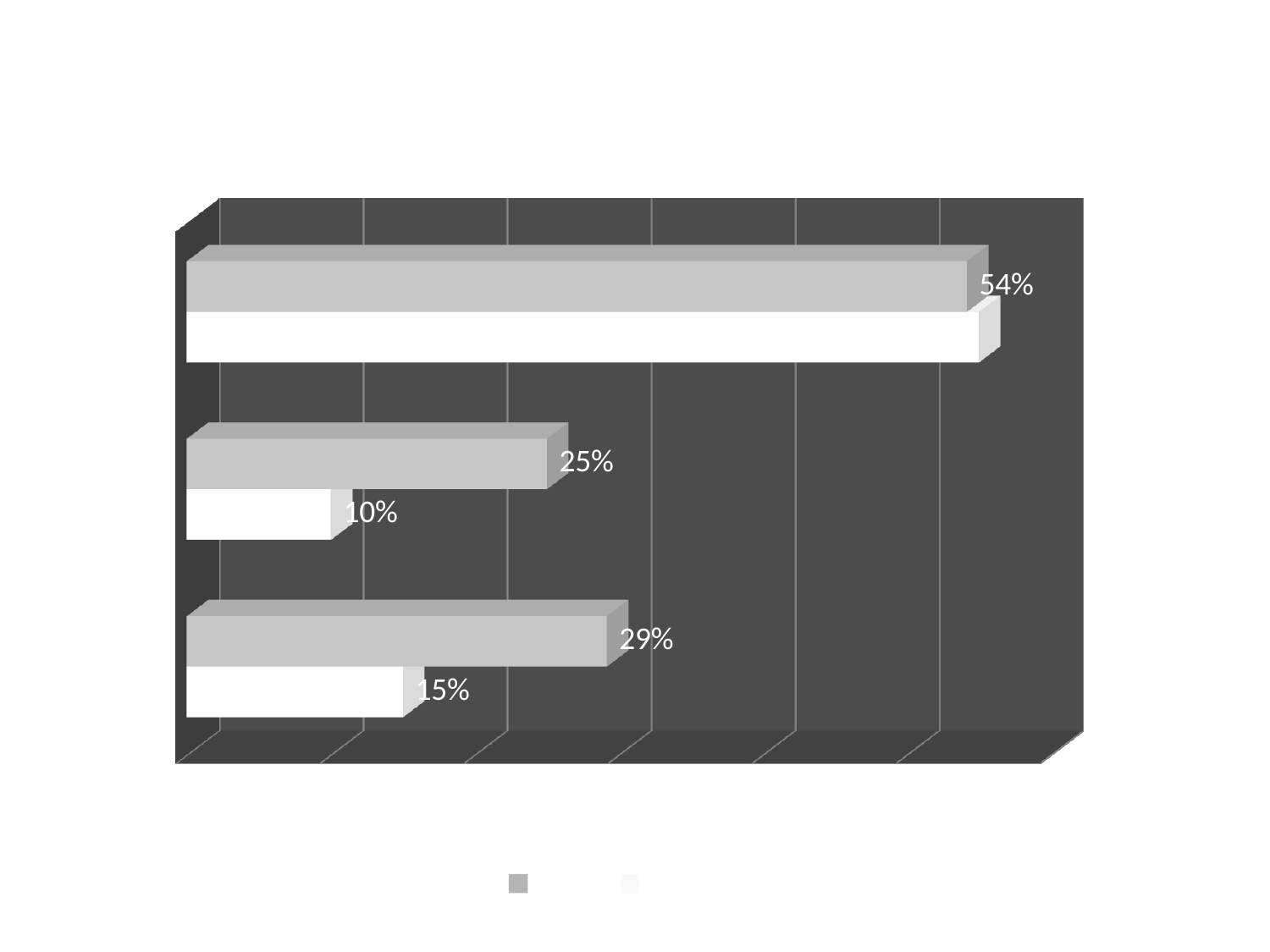
Which group (top, middle or bottom) has the highest gray bar value? top What is the difference between the gray bar and the white bar in the middle group? 15% What is the value labelled on the white bar in the bottom group? 15% Which is larger, the gray bar in the middle group or the gray bar in the bottom group? the gray bar in the bottom group What kind of chart is shown on the slide? bar chart What is the value labelled on the gray bar in the middle group? 25% How many series does the legend list? 2 How many groups of bars (categories) does the chart show? 3 What is the difference between the gray bar and the white bar in the bottom group? 14% What is the value labelled on the gray bar in the bottom group? 29% What is the value labelled on the gray bar in the top group? 54% What is the value labelled on the white bar in the middle group? 10%